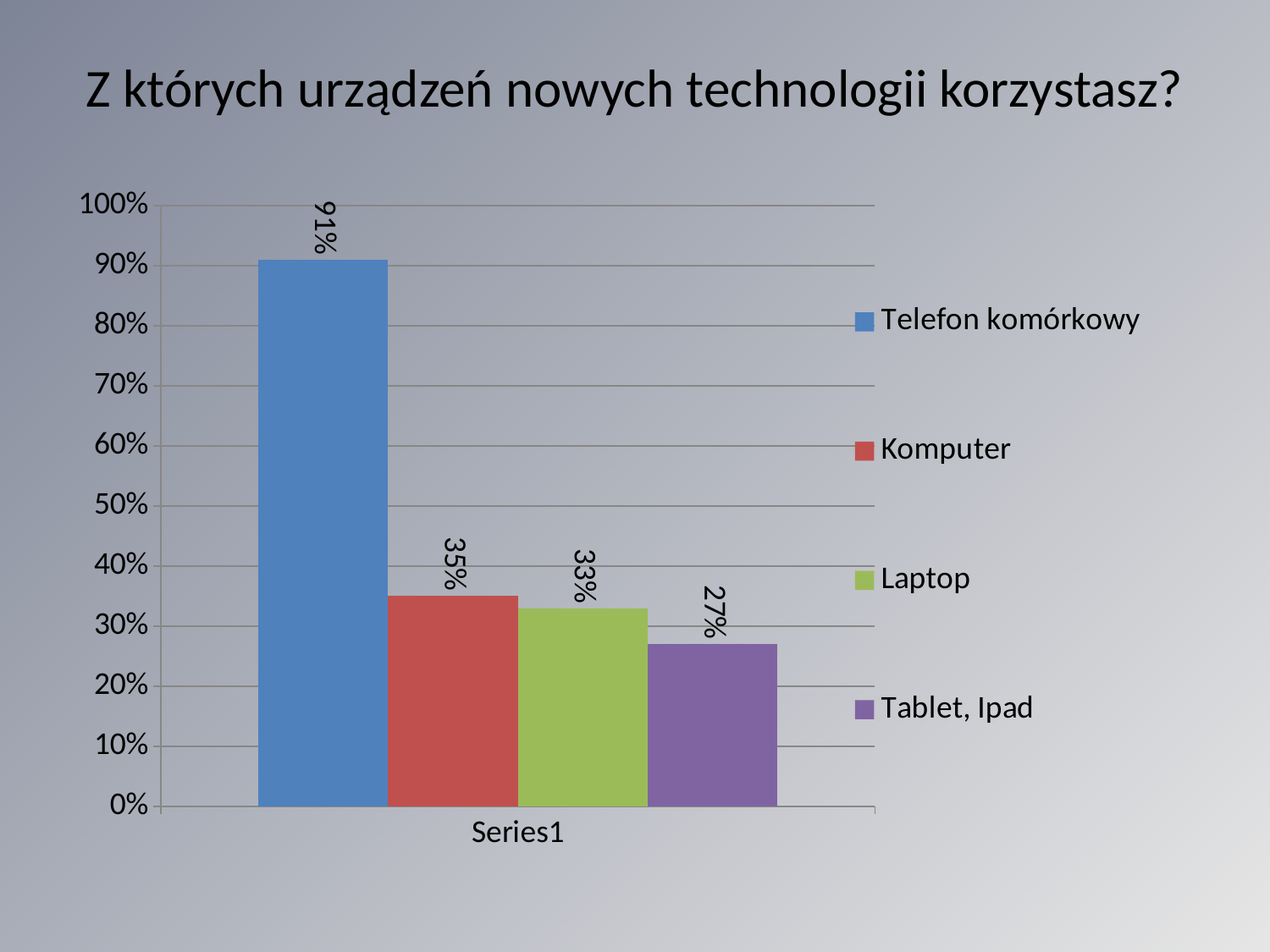
What is the title of the chart on the slide? Z których urządzeń nowych technologii korzystasz? What is the value for Telefon komórkowy? 91% Which device has the highest value? Telefon komórkowy Which device has the lowest value? Tablet, Ipad What is the value for Laptop? 33% What is the value for Tablet, Ipad? 27% What is the difference between the values for Laptop and Tablet, Ipad? 6% How many series does the legend list? 4 What is the value for Komputer? 35% Which is larger, the value for Komputer or the value for Tablet, Ipad? Komputer What is the difference between the values for Telefon komórkowy and Komputer? 56% What kind of chart is shown on the slide? bar chart